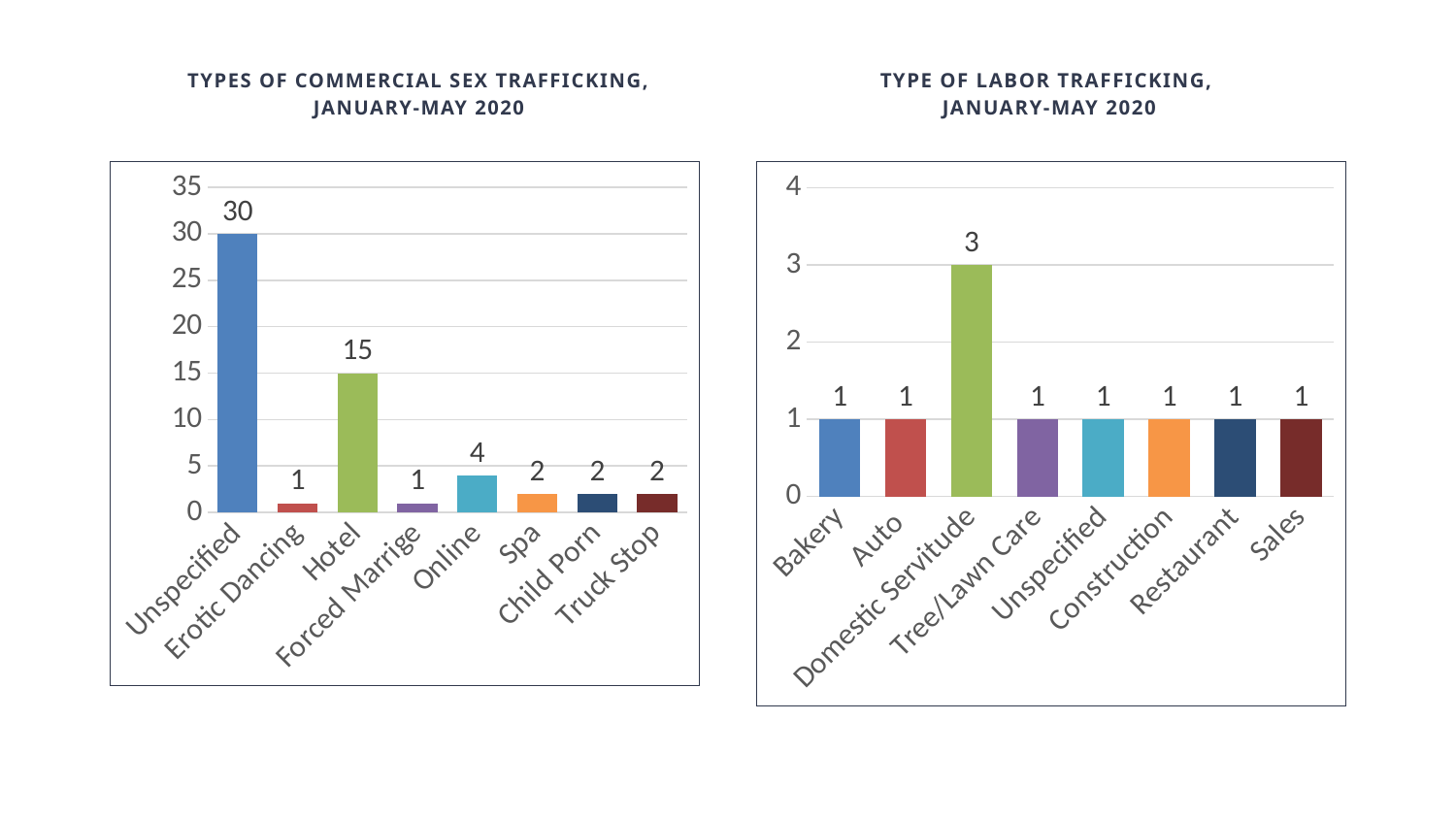
In the 'Types of Commercial Sex Trafficking, January-May 2020' chart, what is the value for Online? 4 In the 'Type of Labor Trafficking, January-May 2020' chart, what is the value for Domestic Servitude? 3 In the 'Types of Commercial Sex Trafficking, January-May 2020' chart, what is the difference between Unspecified and Hotel? 15 In the 'Type of Labor Trafficking, January-May 2020' chart, how many categories are shown? 8 In the 'Types of Commercial Sex Trafficking, January-May 2020' chart, what is the value for Hotel? 15 In the 'Type of Labor Trafficking, January-May 2020' chart, which category has the highest value? Domestic Servitude In the 'Types of Commercial Sex Trafficking, January-May 2020' chart, which category has the highest value? Unspecified In the 'Type of Labor Trafficking, January-May 2020' chart, what is the value for Restaurant? 1 In the 'Types of Commercial Sex Trafficking, January-May 2020' chart, which is larger, Online or Spa? Online In the 'Types of Commercial Sex Trafficking, January-May 2020' chart, how many categories are shown? 8 In the 'Types of Commercial Sex Trafficking, January-May 2020' chart, is the value for Unspecified greater or less than 25? greater What kind of chart is the 'Type of Labor Trafficking, January-May 2020' chart? Bar chart